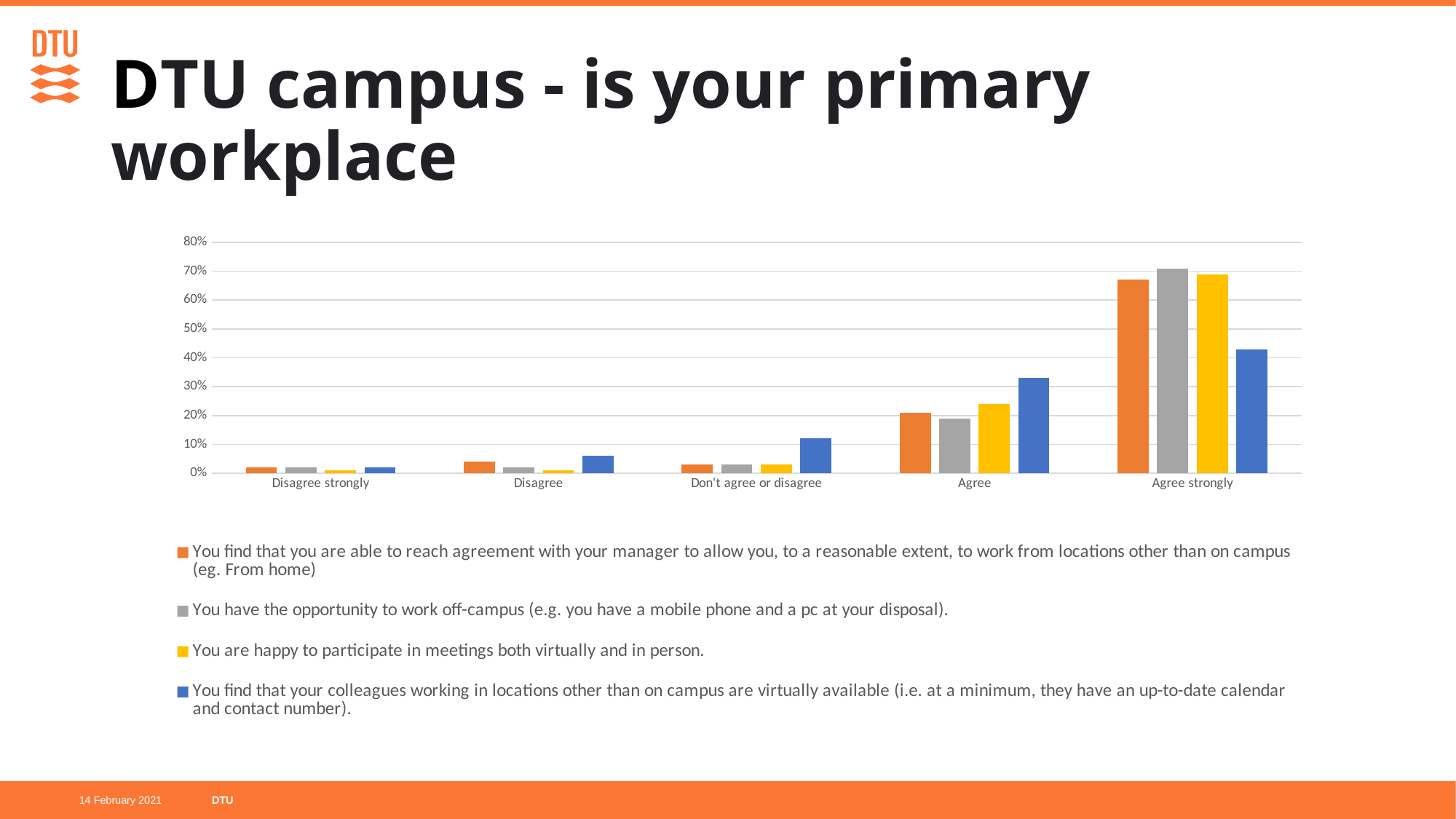
Which colour represents the series 'You are happy to participate in meetings both virtually and in person.'? Yellow For the blue series (colleagues working off campus are virtually available), which category has the lowest value? Disagree strongly How many response categories are shown along the x axis? 5 In the 'Agree' category, which is larger: the blue series or the orange series? Blue series How many series does the legend list? 4 Is the value for 'Agree strongly' in the blue series (colleagues working off campus are virtually available) greater or less than 50%? less For the orange series (reach agreement with your manager to work from other locations), which category has the highest value? Agree strongly In the 'Agree strongly' category, which is larger: the grey series or the blue series? Grey series What kind of chart is shown on the slide? Bar chart Is the value for 'Don't agree or disagree' in the blue series greater or less than 20%? less Is the value for 'Agree strongly' in the grey series (opportunity to work off-campus) greater or less than 60%? greater